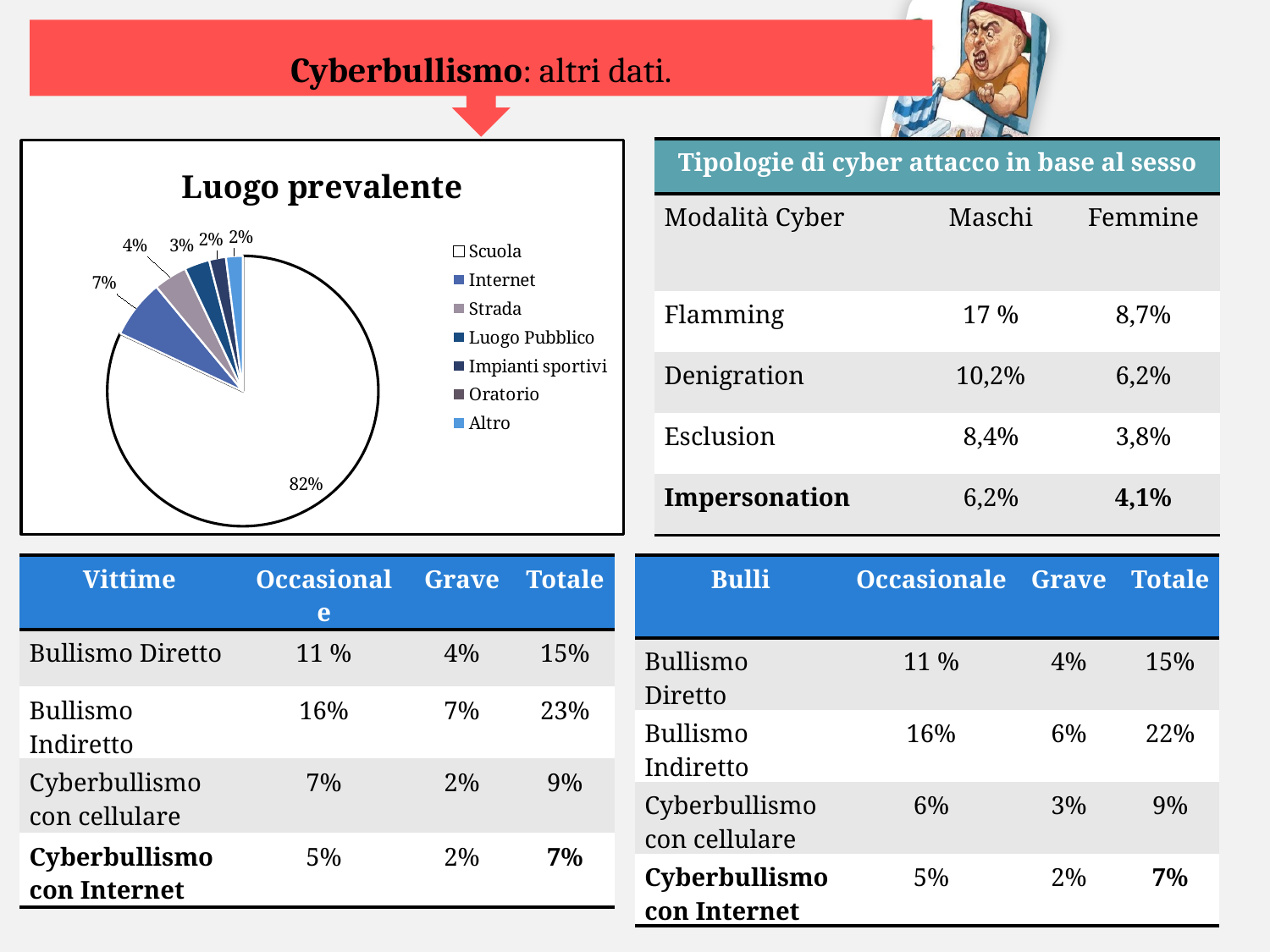
In the "Luogo prevalente" pie chart, what percentage is shown for Strada? 4% What type of chart is shown under the title "Luogo prevalente"? pie chart In the "Luogo prevalente" pie chart, which is larger: Internet or Strada? Internet In the "Luogo prevalente" pie chart, what percentage is shown for Internet? 7% Which category has the largest slice in the "Luogo prevalente" pie chart? Scuola In the "Luogo prevalente" pie chart, what share of the pie does Scuola take? 82% In the "Luogo prevalente" pie chart, what percentage is shown for Scuola? 82% In the "Luogo prevalente" pie chart, what is the difference in percentage points between Strada and Luogo Pubblico? 1 In the "Luogo prevalente" pie chart, what is the difference in percentage points between Scuola and Internet? 75 How many categories are listed in the legend of the "Luogo prevalente" pie chart? 7 In the "Luogo prevalente" pie chart, what percentage is shown for Luogo Pubblico? 3% What is the title of the pie chart on the slide? Luogo prevalente